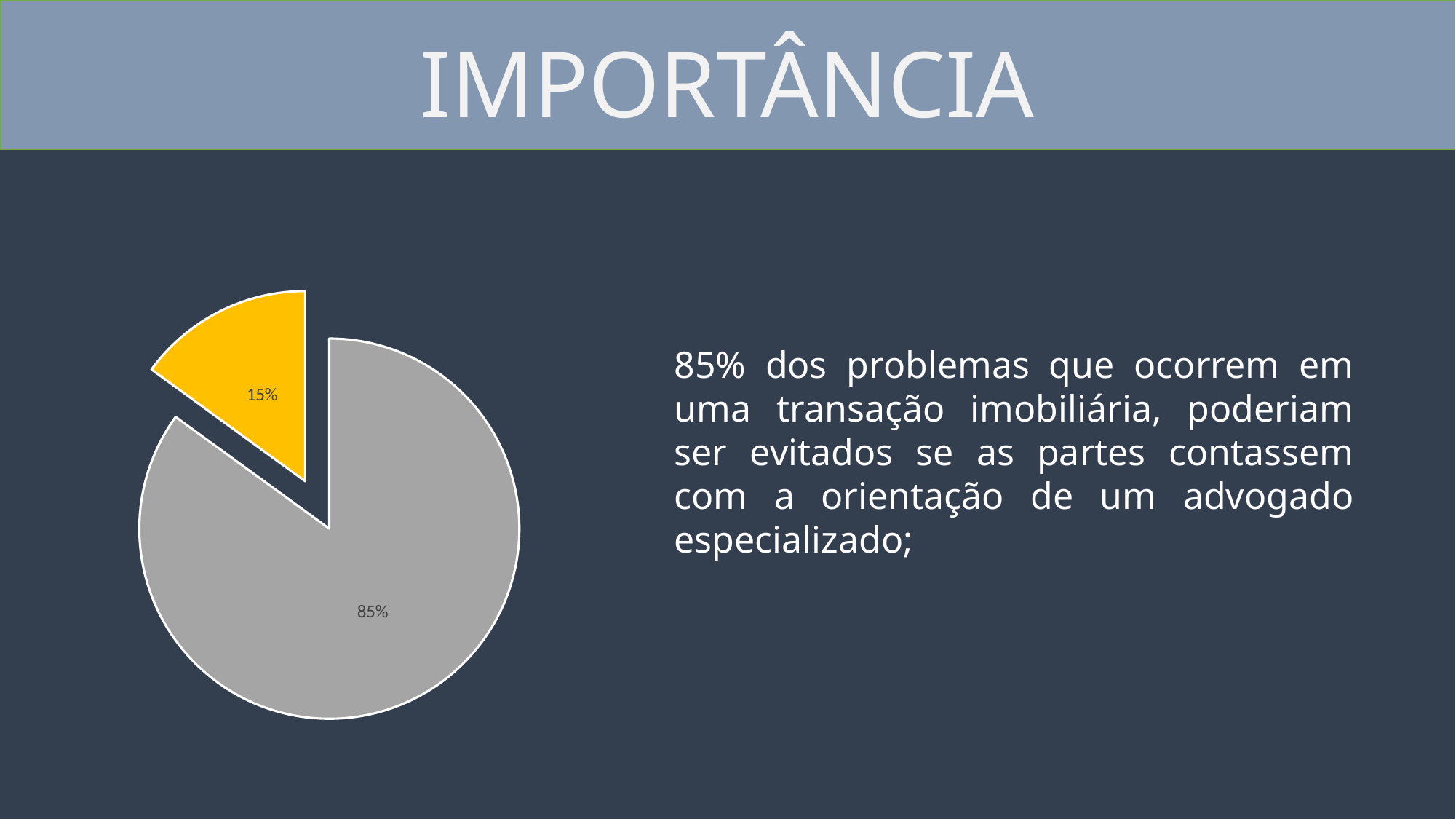
What is the title of the slide containing the pie chart? IMPORTÂNCIA Which slice of the pie chart is pulled out (exploded) from the rest? the yellow 15% slice How many slices does the pie chart have? 2 What percentage is shown on the yellow slice of the pie chart? 15% What share of the pie does the yellow slice represent? 15% Which slice of the pie chart is the largest? the gray slice (85%) What kind of chart is shown on the slide? pie chart What is the difference in percentage points between the gray slice and the yellow slice? 70 What percentage is shown on the gray slice of the pie chart? 85% What is the total of the two slice percentages shown on the pie chart? 100% Which is larger, the gray slice or the yellow slice? the gray slice Which slice of the pie chart is the smallest? the yellow slice (15%)